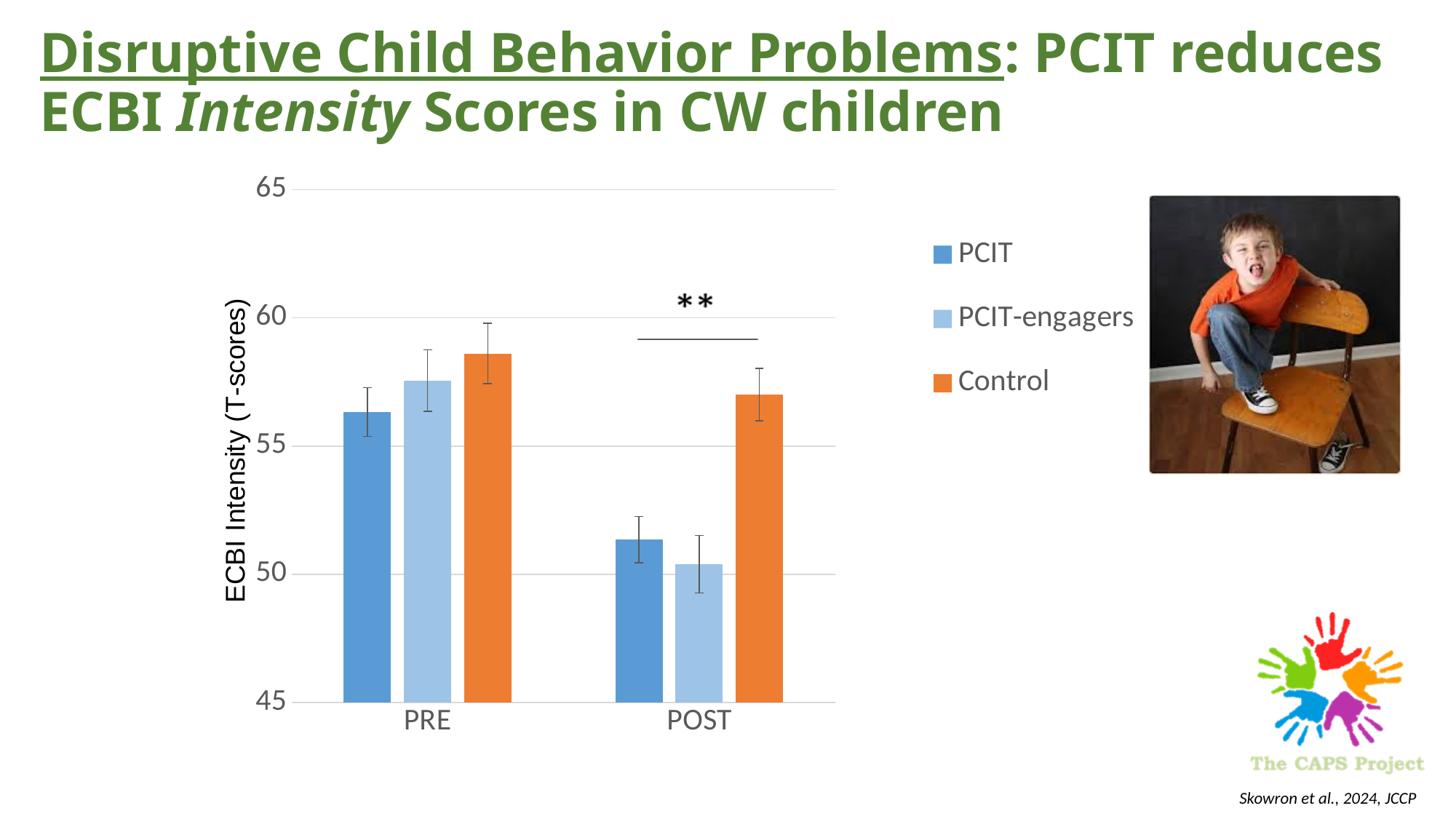
Is the value for Control at POST greater or less than 55? greater What is the label of the y axis? ECBI Intensity (T-scores) How many categories are shown on the x axis? 2 Is the value for Control at PRE greater or less than 55? greater Which series has the highest value at POST? Control What kind of chart is shown on the slide? bar chart How many series does the legend list? 3 Which series is shown in orange in the legend? Control Is the value for PCIT-engagers at POST greater or less than 55? less Does the value for PCIT rise or fall from PRE to POST? fall Which is larger at POST, the value for PCIT or the value for Control? Control